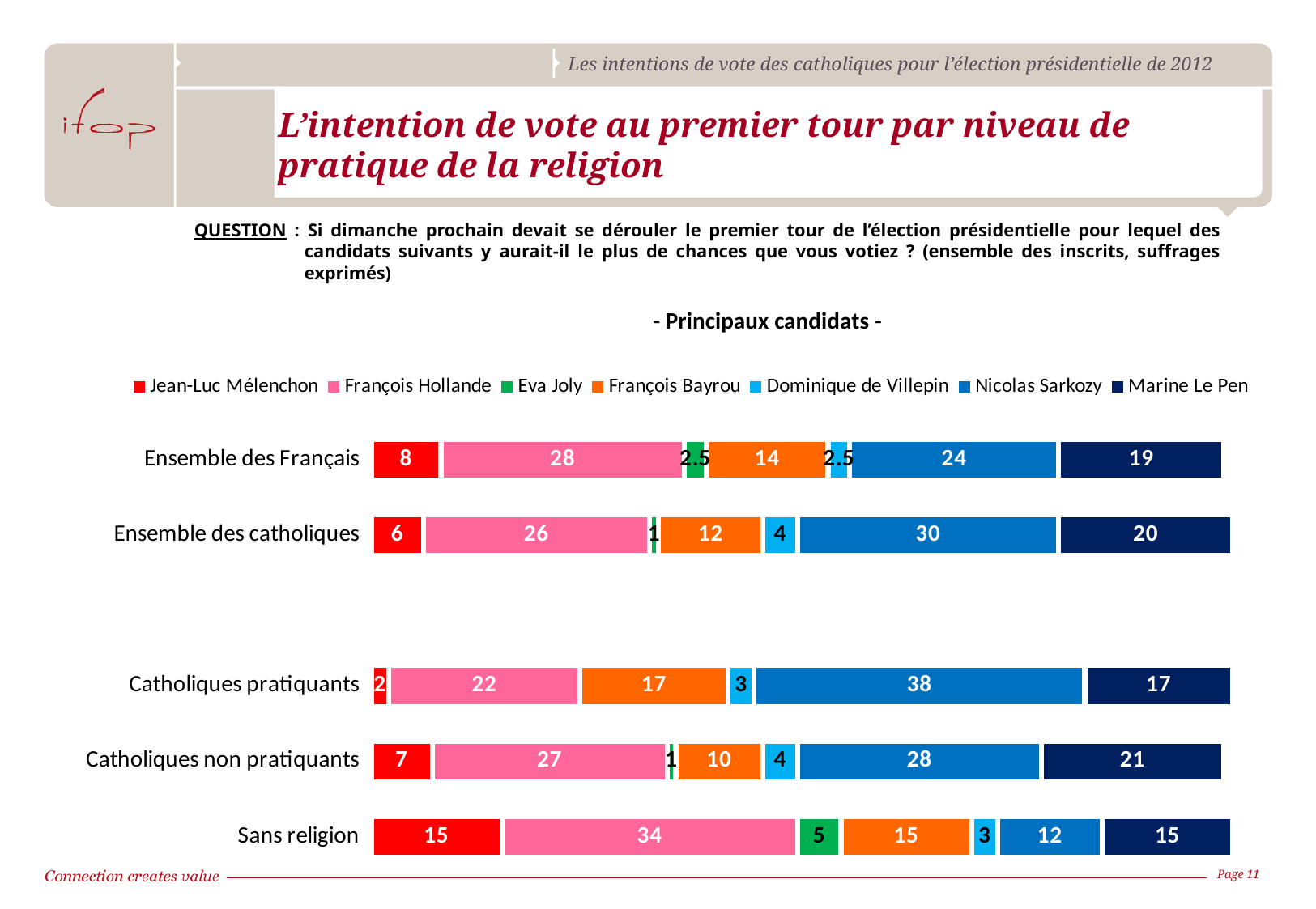
What is the difference between the Nicolas Sarkozy value for Ensemble des catholiques and for Ensemble des Français? 6 What kind of chart is shown on the slide? Stacked bar chart Which category has the lowest value for Jean-Luc Mélenchon? Catholiques pratiquants What is the value for Marine Le Pen among Catholiques non pratiquants? 21 Which legend entry is shown in green? Eva Joly How many series does the legend list? 7 How many categories (rows) are plotted in the chart? 5 What is the value for Nicolas Sarkozy among Catholiques pratiquants? 38 Which is larger: the François Bayrou value for Catholiques pratiquants or for Catholiques non pratiquants? Catholiques pratiquants What is the value for Eva Joly for Ensemble des Français? 2.5 Which category has the highest value for Nicolas Sarkozy? Catholiques pratiquants What is the value for François Hollande among Sans religion? 34